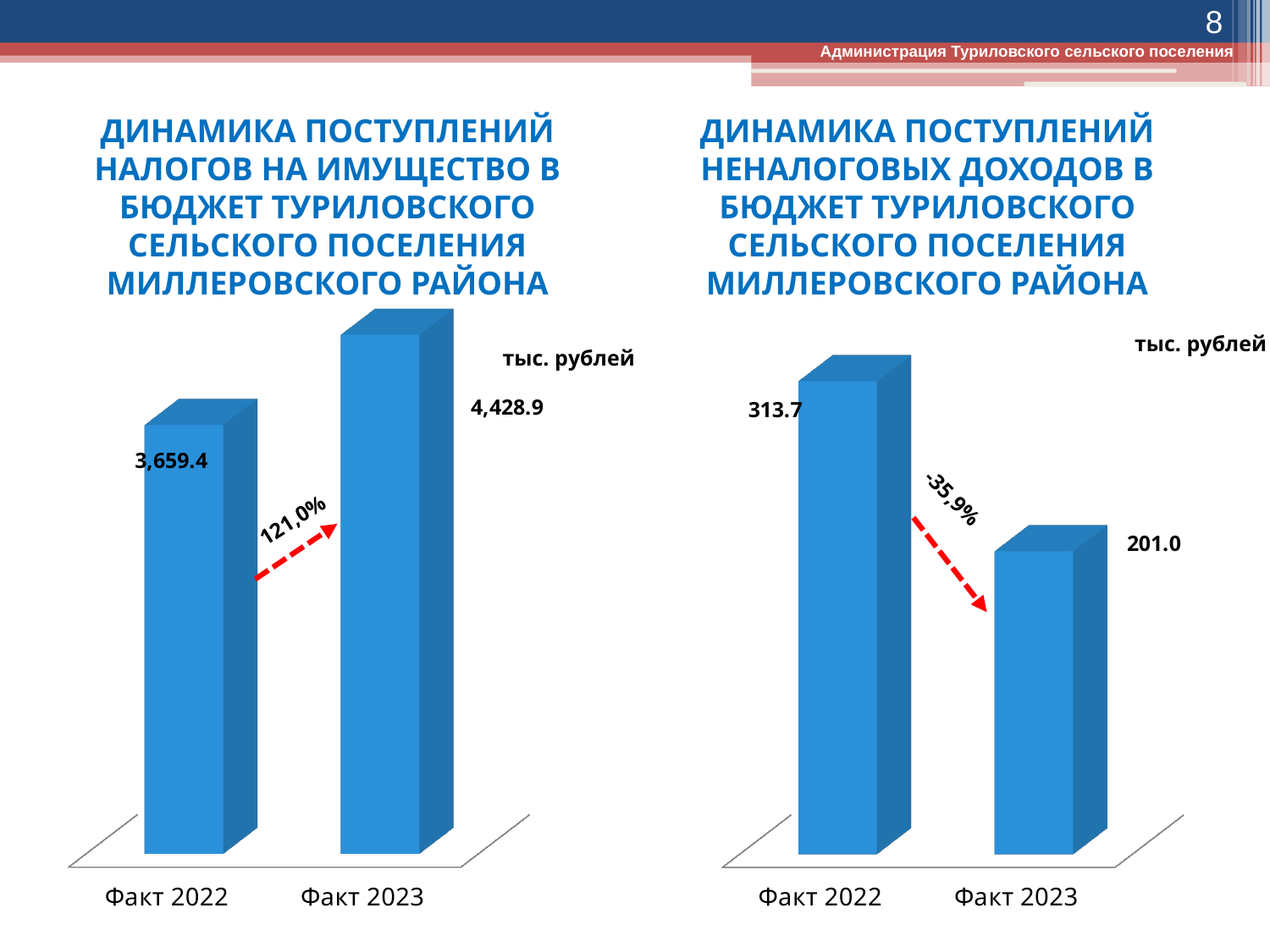
In the right chart (non-tax revenues), what is the value for Факт 2023? 201.0 In the left chart (property taxes), what is the difference between the Факт 2023 and Факт 2022 values? 769.5 In the left chart (property taxes), do the values rise or fall from Факт 2022 to Факт 2023? rise What percentage change is shown by the arrow in the right chart (non-tax revenues)? -35,9% In the right chart (non-tax revenues), do the values rise or fall from Факт 2022 to Факт 2023? fall What type of chart is the left chart (property taxes)? bar chart In the right chart (non-tax revenues), what is the value for Факт 2022? 313.7 In the left chart (property taxes), what is the value for Факт 2023? 4,428.9 In the left chart (property taxes), what is the value for Факт 2022? 3,659.4 In the right chart (non-tax revenues), what is the difference between the Факт 2022 and Факт 2023 values? 112.7 In the left chart (property taxes), which category has the higher value? Факт 2023 In the right chart (non-tax revenues), which category has the lower value? Факт 2023